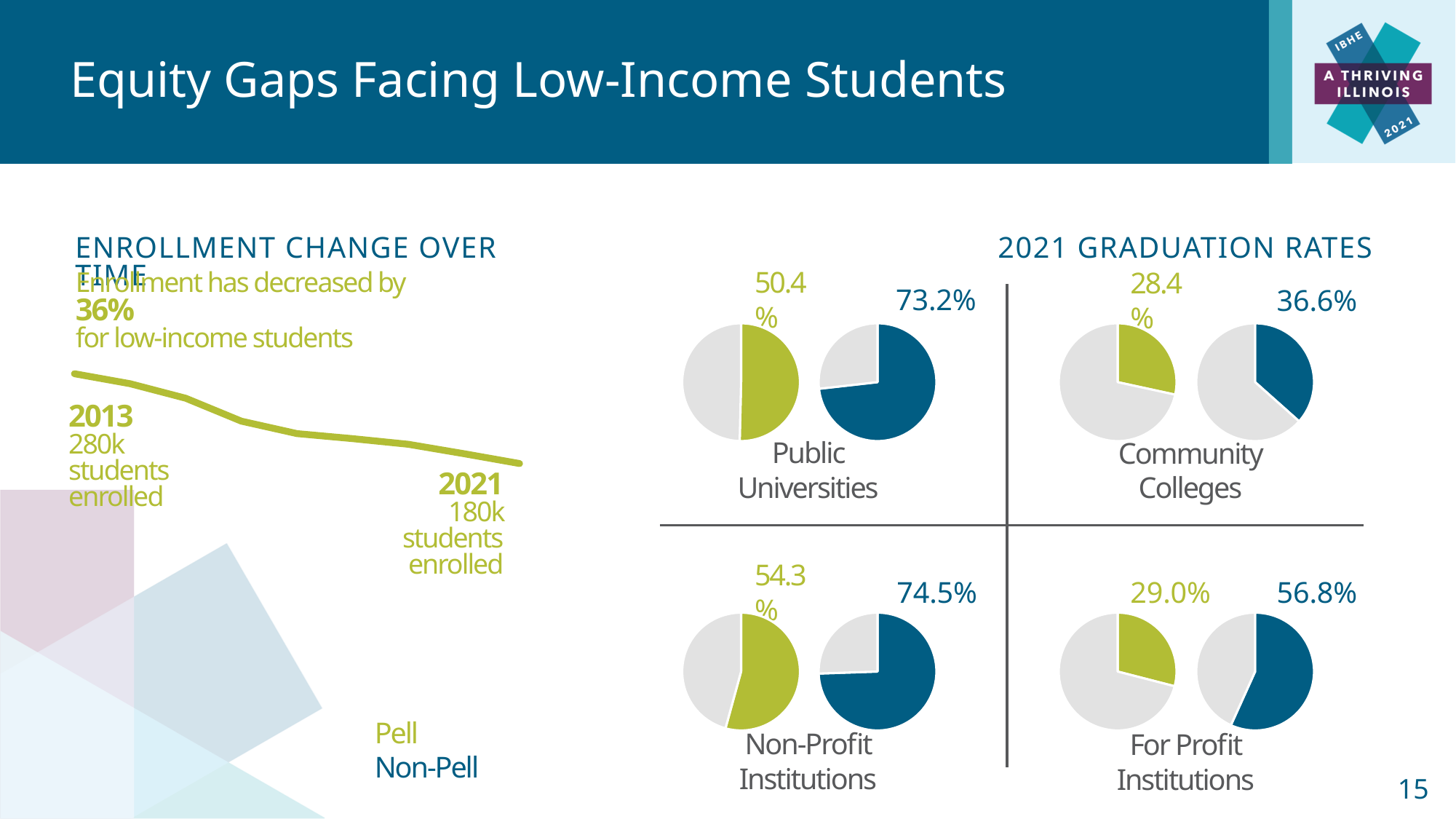
In the Enrollment Change Over Time chart, how many students were enrolled in 2013? 280k In the 2021 Graduation Rates charts, is the Pell graduation rate higher at Non-Profit Institutions or at Community Colleges? Non-Profit Institutions In the 2021 Graduation Rates charts, what is the difference between the Non-Pell and Pell graduation rates at Public Universities? 22.8% In the Enrollment Change Over Time chart, by how much did enrollment fall between 2013 and 2021? 100k In the 2021 Graduation Rates charts, what is the Pell graduation rate for Public Universities? 50.4% In the 2021 Graduation Rates charts, what is the Non-Pell graduation rate for For Profit Institutions? 56.8% In the 2021 Graduation Rates charts, what is the Non-Pell graduation rate for Community Colleges? 36.6% In the 2021 Graduation Rates charts, which institution type has the lowest Non-Pell graduation rate? Community Colleges In the 2021 Graduation Rates charts, which institution type has the highest Pell graduation rate? Non-Profit Institutions In the Enrollment Change Over Time chart, does enrollment rise or fall from 2013 to 2021? fall What kind of chart is used to show the 2021 Graduation Rates? pie chart In the 2021 Graduation Rates charts, what is the difference between the Non-Pell and Pell graduation rates at For Profit Institutions? 27.8%